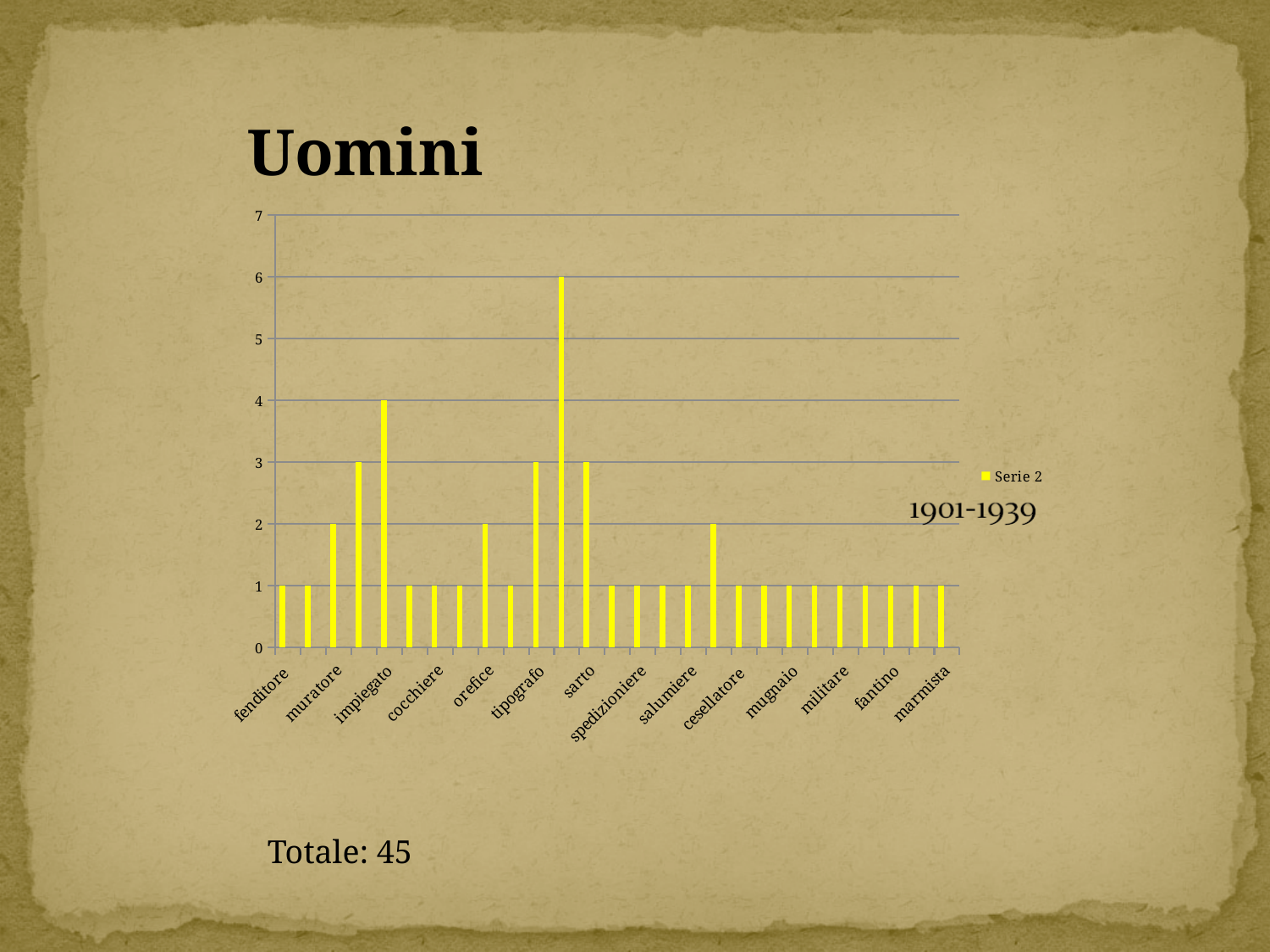
What kind of chart is shown on the slide? bar chart What is the title of the chart? Uomini Which is larger, the value for impiegato or the value for cocchiere? impiegato What is the value for muratore? 2 What is the value for marmista? 1 Is the value for sarto greater or less than 2? greater What is the value for impiegato? 4 What is the value for orefice? 2 How many series does the legend list? 1 What is the value for tipografo? 3 What is the difference between the values for impiegato and muratore? 2 What is the highest value reached by any bar in the chart? 6